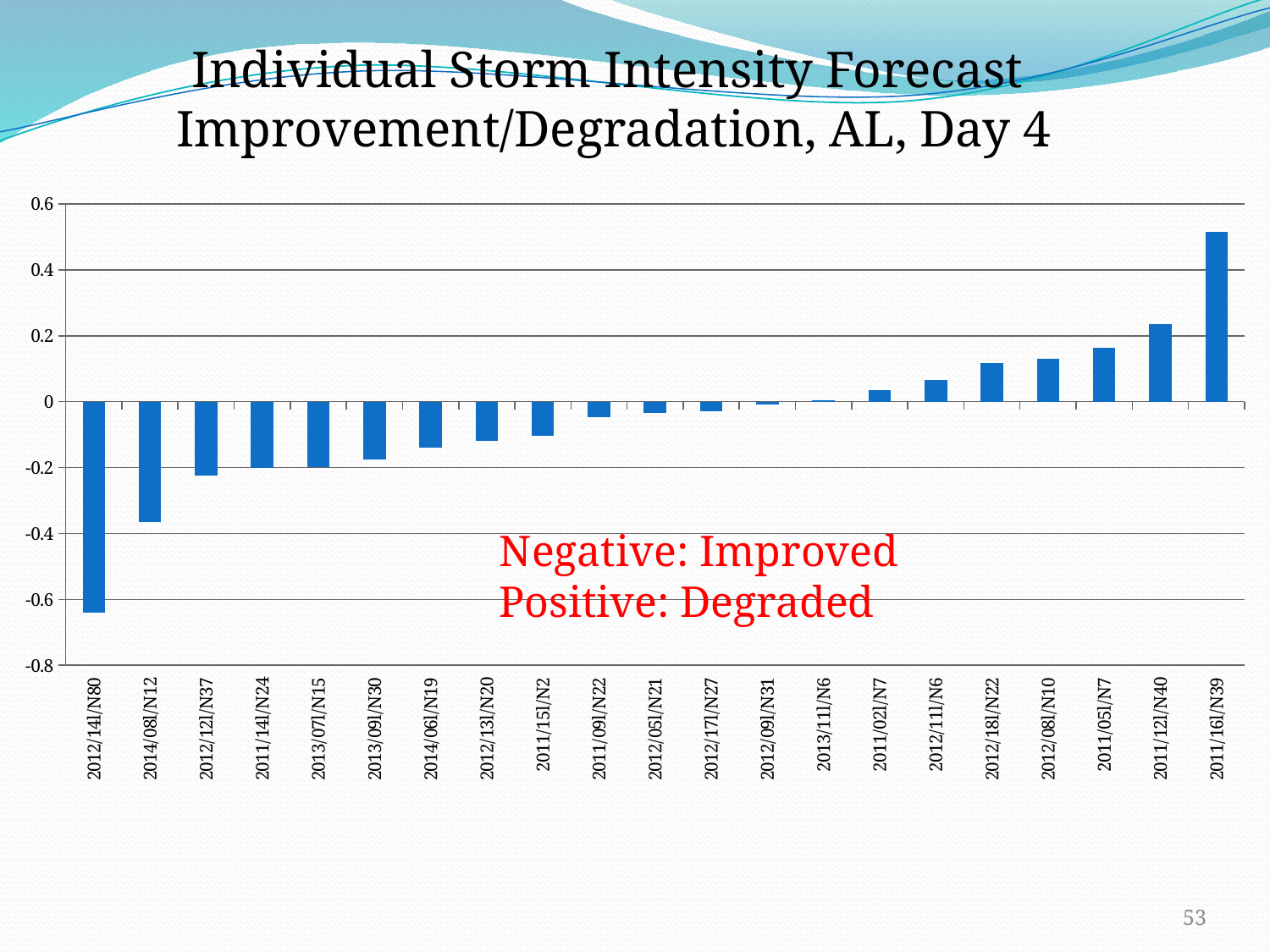
Do the values rise or fall moving from left to right along the x axis? rise Is the value for 2011/16l/N39 greater or less than 0.4? greater Is the value for 2012/14l/N80 greater or less than -0.6? less Is the value for 2014/08l/N12 greater or less than -0.2? less According to the annotation on the chart, what does a negative value indicate? Improved Which storm has the lowest value? 2012/14l/N80 What is the title of the chart? Individual Storm Intensity Forecast Improvement/Degradation, AL, Day 4 What kind of chart is shown on the slide? bar chart How many storms (categories) are plotted on the x axis? 21 Which has the larger value, 2011/16l/N39 or 2011/12l/N40? 2011/16l/N39 Which storm has the highest value? 2011/16l/N39